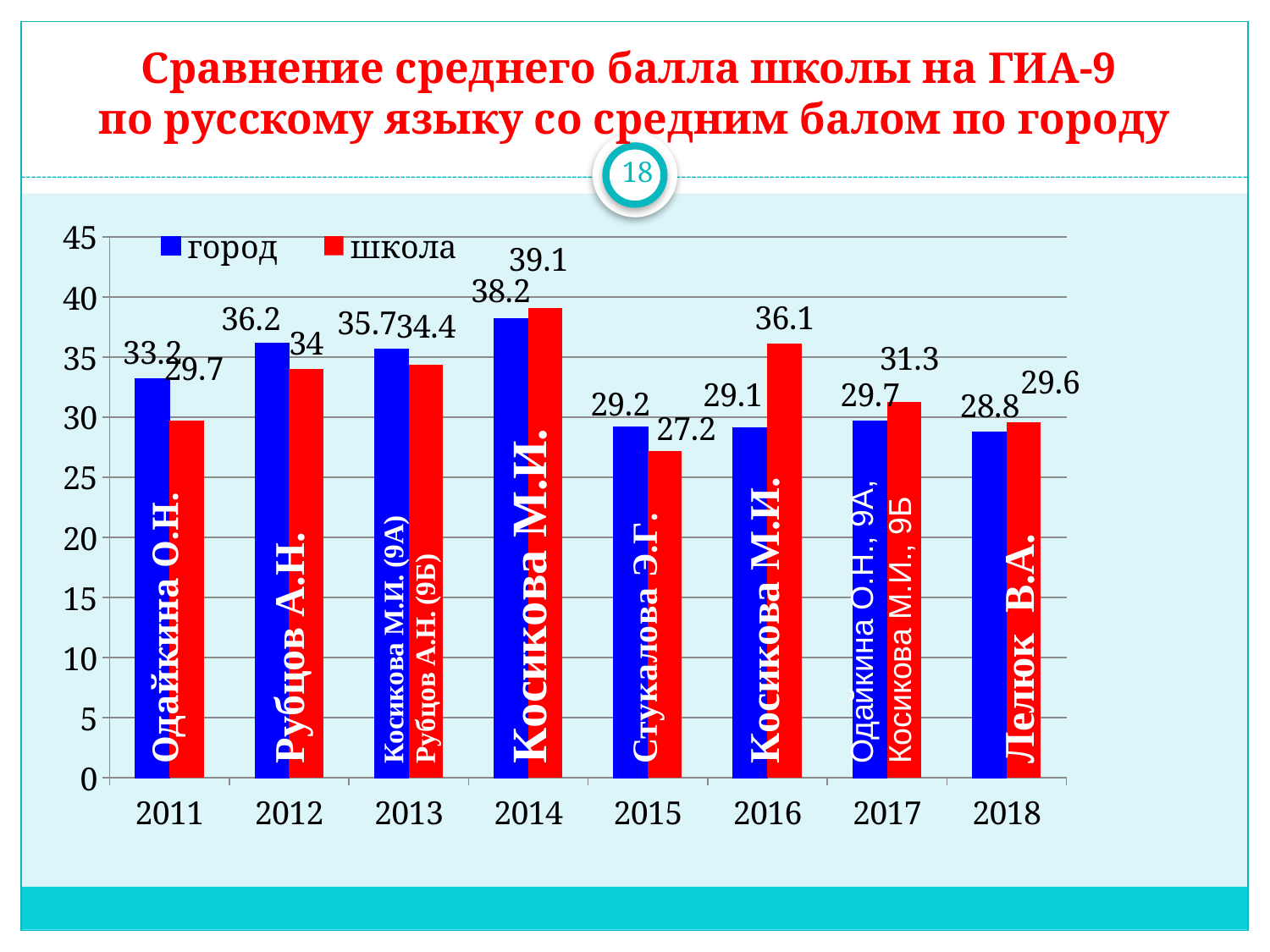
What is the value for школа in 2015? 27.2 What kind of chart is shown on the slide? bar chart What is the value for школа in 2016? 36.1 In which year is the школа value highest? 2014 In which year is the школа value lowest? 2015 Is the value for школа in 2012 greater or less than 30? greater What is the difference between the город and школа values in 2016? 7 What is the value for город in 2014? 38.2 How many series does the legend list? 2 Which is larger in 2011, the город value or the школа value? город How many years are shown on the x axis? 8 What is the value for город in 2018? 28.8